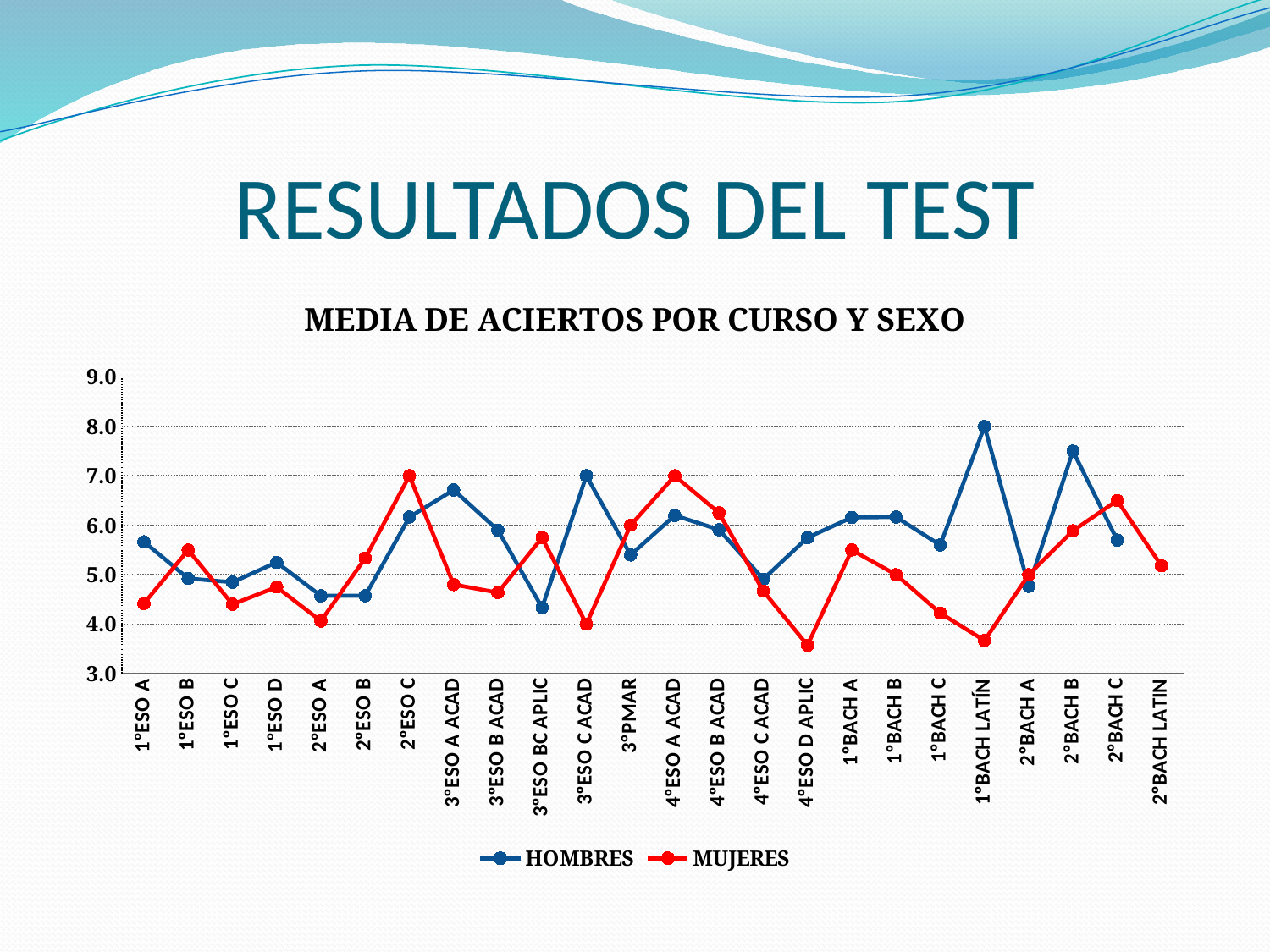
What is the HOMBRES value for 1°BACH LATÍN? 8.0 What is the difference between the HOMBRES value and the MUJERES value at 3°ESO C ACAD? 3.0 For which course is the HOMBRES value highest? 1°BACH LATÍN How many series does the legend list? 2 How many courses (categories) are plotted along the x axis? 24 What is the MUJERES value for 3°ESO C ACAD? 4.0 At 2°BACH C, which series has the larger value, HOMBRES or MUJERES? MUJERES What kind of chart is shown on the slide? line chart Is the MUJERES value for 4°ESO D APLIC greater or less than 4.0? less Which colour is used for the MUJERES series? red What is the title of the chart? MEDIA DE ACIERTOS POR CURSO Y SEXO Is the HOMBRES value for 2°BACH B greater or less than 7.0? greater